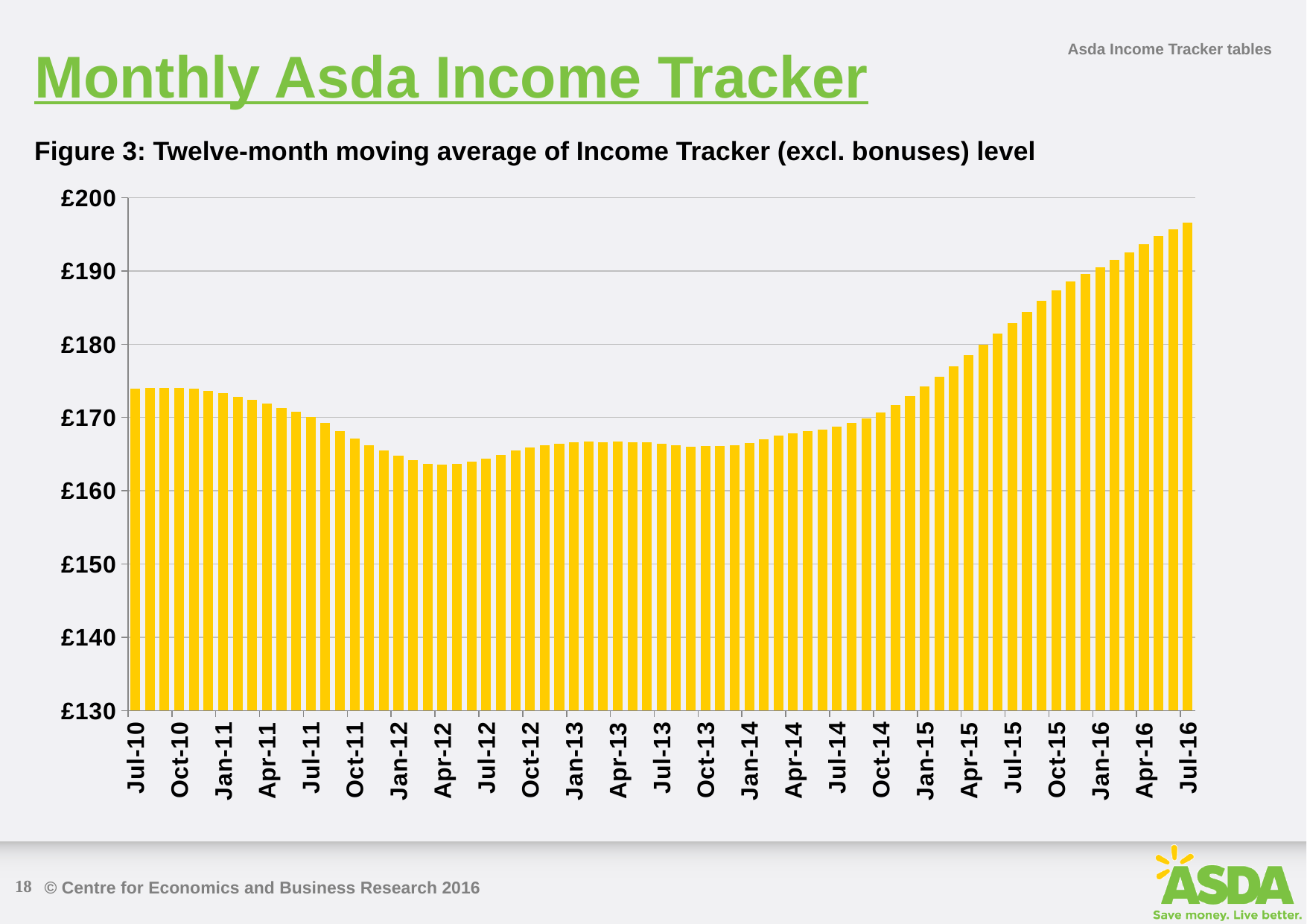
Which is larger, the value for Jan-14 or the value for Jan-15? Jan-15 Is the value for Apr-12 greater or less than £170? less Is the value for Jul-16 greater or less than £190? greater Which is larger, the value for Jul-10 or the value for Jul-12? Jul-10 Do the values rise or fall from Jan-15 to Jul-16? rise Is the value for Jul-10 greater or less than £170? greater What kind of chart is shown on the slide? Bar chart Do the values rise or fall from Jul-10 to Apr-12? fall Which month has the highest twelve-month moving average value? Jul-16 What is the title of the figure shown on the slide? Figure 3: Twelve-month moving average of Income Tracker (excl. bonuses) level